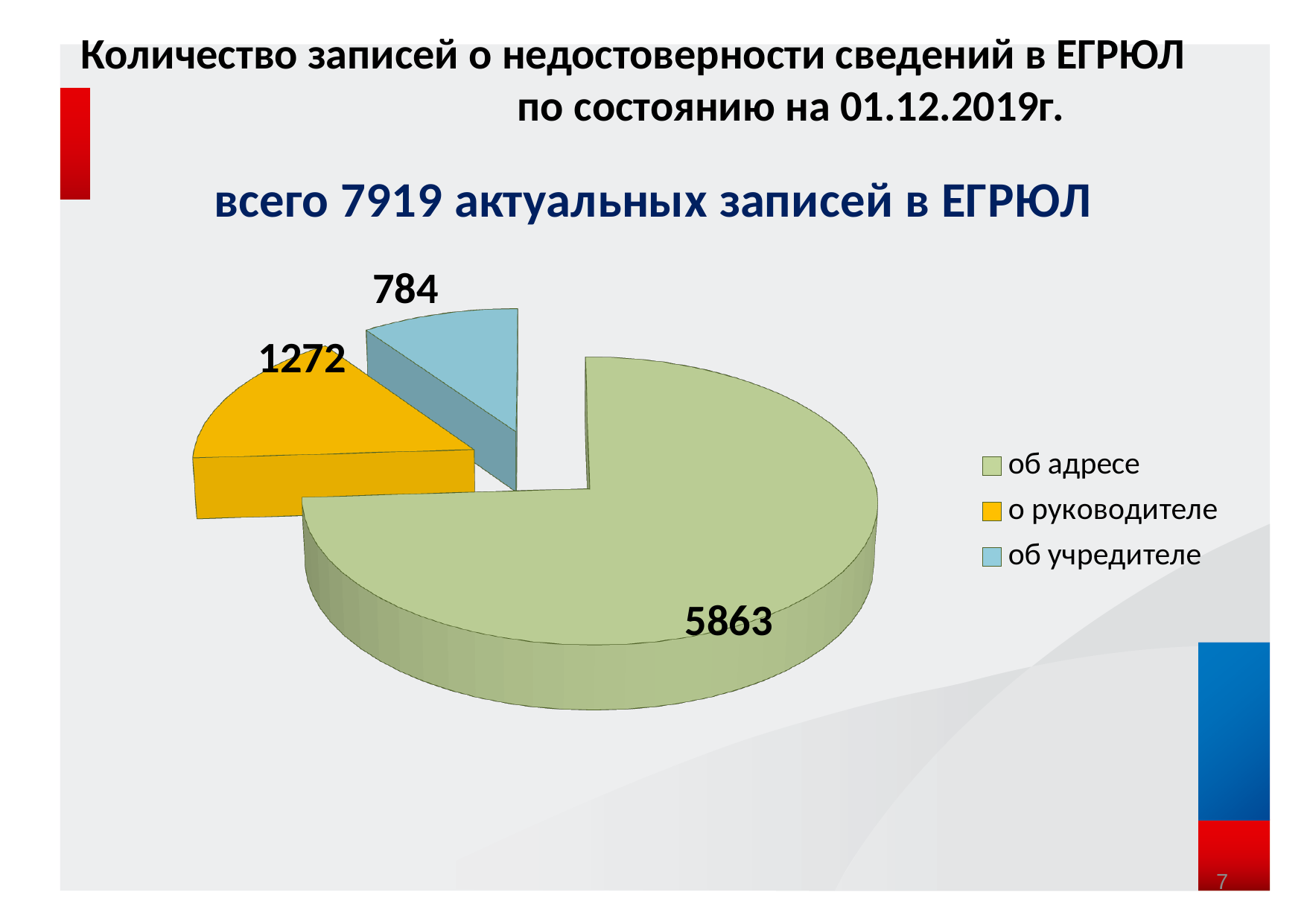
What is the value for "об адресе"? 5863 How many slices does the pie chart have? 3 Which category has the largest slice? об адресе Which is larger, the value for "о руководителе" or the value for "об учредителе"? о руководителе How many entries does the legend list? 3 What is the difference between the values for "об адресе" and "о руководителе"? 4591 What is the difference between the values for "о руководителе" and "об учредителе"? 488 What is the value for "о руководителе"? 1272 What type of chart is shown on the slide? pie chart Which category has the smallest slice? об учредителе What is the value for "об учредителе"? 784 What total number of current records in ЕГРЮЛ is stated on the slide? 7919